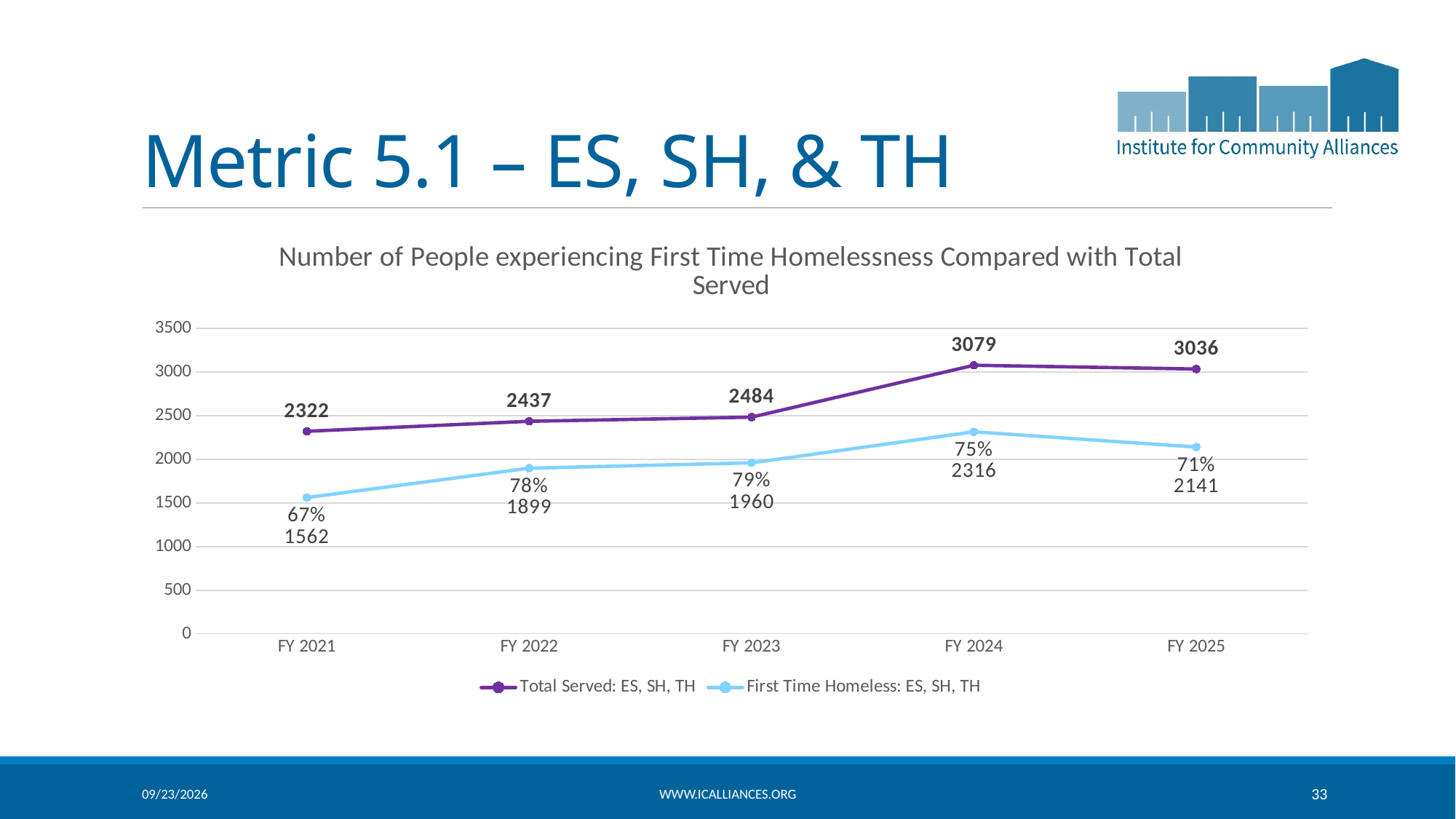
Does Total Served: ES, SH, TH rise or fall from FY 2021 to FY 2024? rise What kind of chart is shown on the slide? line chart Which is larger: First Time Homeless in FY 2024 or First Time Homeless in FY 2025? FY 2024 What is the difference between Total Served and First Time Homeless in FY 2025? 895 Is the Total Served value for FY 2022 greater or less than 2000? greater How many series does the legend list? 2 How many fiscal years are shown on the x axis? 5 What is the First Time Homeless: ES, SH, TH value for FY 2021? 1562 What is the Total Served: ES, SH, TH value for FY 2024? 3079 In which fiscal year is First Time Homeless: ES, SH, TH lowest? FY 2021 What percentage label is shown for First Time Homeless: ES, SH, TH in FY 2023? 79% In which fiscal year is Total Served: ES, SH, TH highest? FY 2024